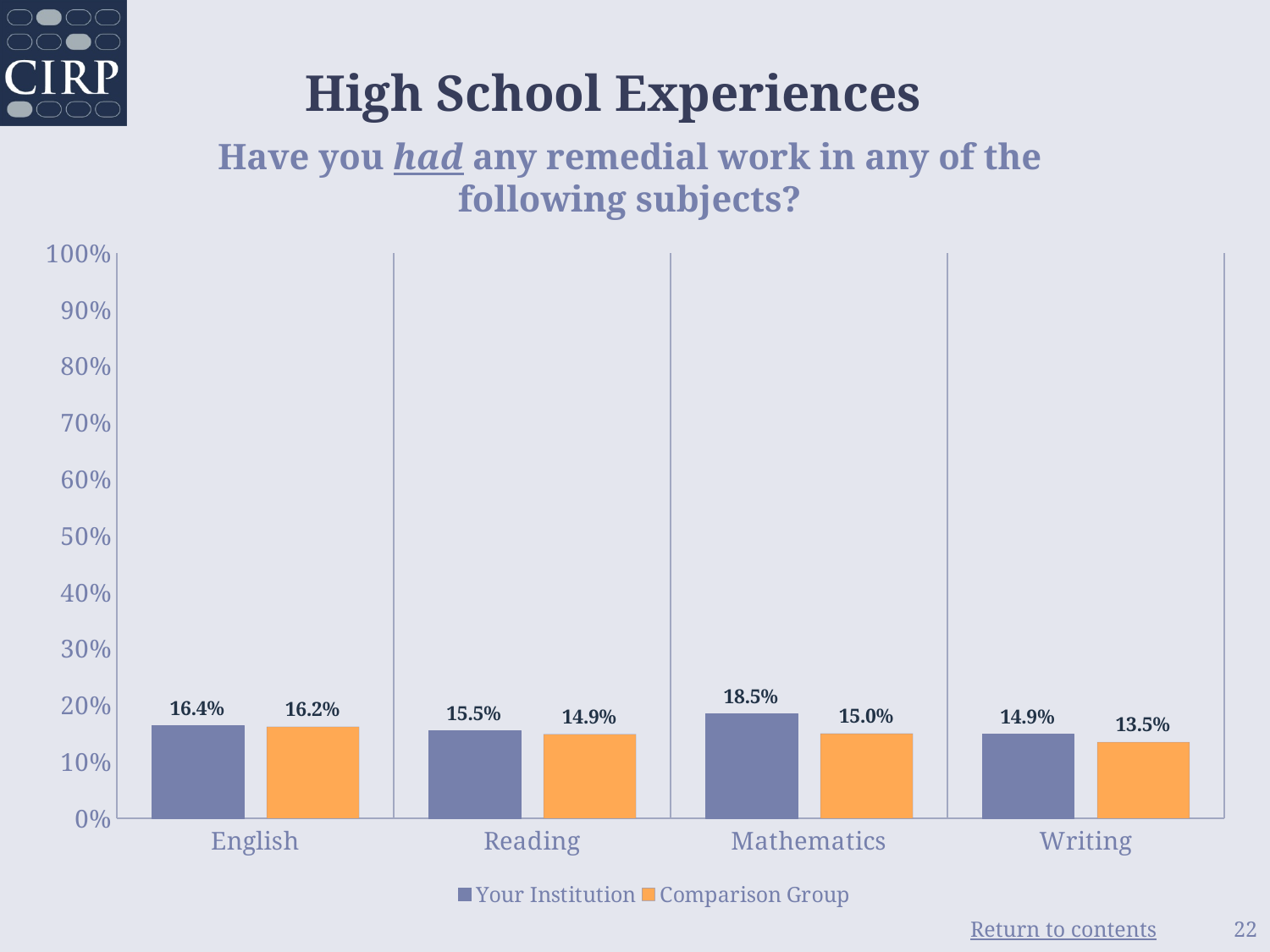
Which subject has the lowest value for Comparison Group? Writing Which subject has the highest value for Your Institution? Mathematics What is the value for Your Institution in Mathematics? 18.5% How many subjects are shown on the x axis? 4 What kind of chart is shown on the slide? bar chart What is the difference between Your Institution and Comparison Group in Mathematics? 3.5% Is the value for Your Institution in English greater or less than 20%? less How many series does the legend list? 2 Which is larger in Mathematics: Your Institution or Comparison Group? Your Institution What is the value for Your Institution in Reading? 15.5% What is the difference between Your Institution and Comparison Group in Writing? 1.4% What is the value for Comparison Group in Writing? 13.5%